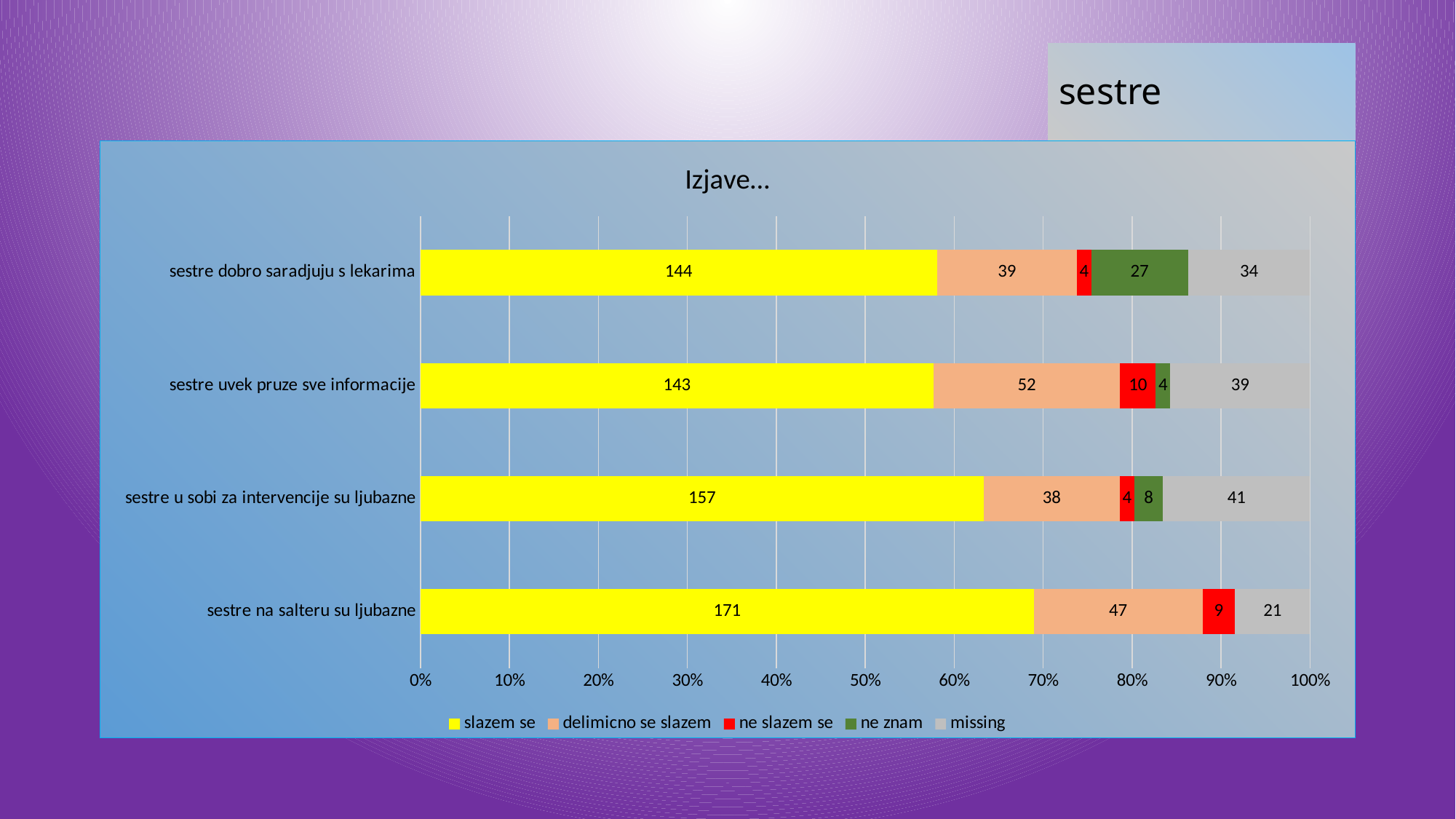
What kind of chart is shown on the slide? stacked bar chart What is the total of all segments in the bar for 'sestre dobro saradjuju s lekarima'? 248 What is the 'slazem se' value for 'sestre na salteru su ljubazne'? 171 What is the 'missing' value for 'sestre u sobi za intervencije su ljubazne'? 41 What is the difference between the 'slazem se' values for 'sestre na salteru su ljubazne' and 'sestre dobro saradjuju s lekarima'? 27 How many series does the legend list? 5 Which statement has the lowest 'missing' value? sestre na salteru su ljubazne Which is larger: the 'ne slazem se' value for 'sestre uvek pruze sve informacije' or for 'sestre na salteru su ljubazne'? sestre uvek pruze sve informacije What is the 'delimicno se slazem' value for 'sestre uvek pruze sve informacije'? 52 What is the 'ne znam' value for 'sestre dobro saradjuju s lekarima'? 27 Which statement has the highest 'slazem se' value? sestre na salteru su ljubazne How many categories (statements) are plotted on the chart? 4